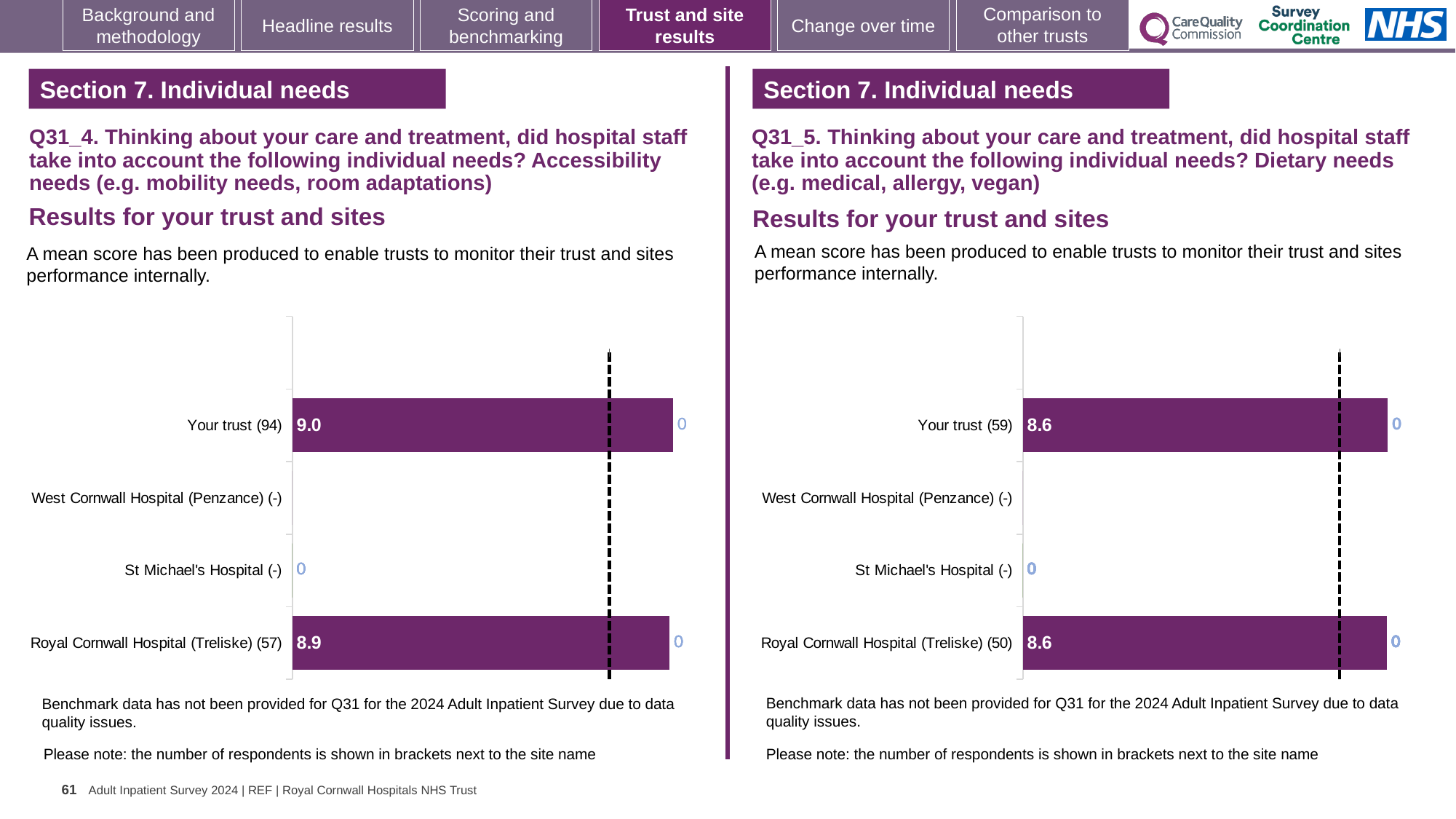
In the Q31_5 chart (Dietary needs), what is the mean score for Your trust (59)? 8.6 In the Q31_5 chart (Dietary needs), how many respondents are shown in brackets for Royal Cornwall Hospital (Treliske)? 50 In the Q31_4 chart (Accessibility needs), how many respondents are shown in brackets for Your trust? 94 In the Q31_5 chart (Dietary needs), is the mean score for Your trust higher than, lower than, or equal to the mean score for Royal Cornwall Hospital (Treliske)? Equal How many site categories are listed on the y axis of the Q31_4 chart (Accessibility needs)? 4 In the Q31_4 chart (Accessibility needs), which has the higher mean score, Your trust or Royal Cornwall Hospital (Treliske)? Your trust What kind of chart is used for the Q31_5 (Dietary needs) results? Bar chart In the Q31_4 chart (Accessibility needs), what is the mean score for Royal Cornwall Hospital (Treliske) (57)? 8.9 In the Q31_5 chart (Dietary needs), what is the mean score for Royal Cornwall Hospital (Treliske) (50)? 8.6 In the Q31_4 chart (Accessibility needs), what is the mean score for Your trust (94)? 9.0 In the Q31_4 chart (Accessibility needs), what is the difference between the mean score for Your trust and the mean score for Royal Cornwall Hospital (Treliske)? 0.1